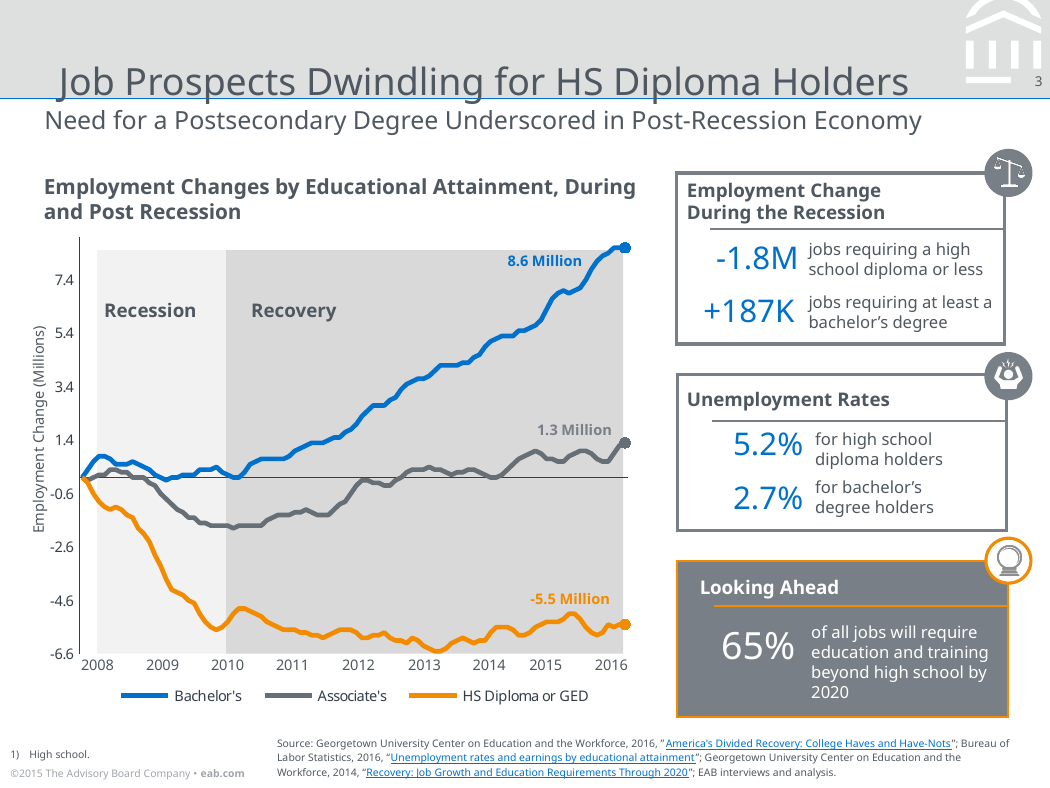
How many series does the chart legend list? 3 Which series has the lowest employment change at the end of the chart? HS Diploma or GED What is the employment change for HS Diploma or GED at the end of the line in 2016? -5.5 Million Is the value for HS Diploma or GED in 2013 greater or less than -4.6? less Which series has the highest employment change at the end of the chart? Bachelor's What is the employment change for Bachelor's at the end of the line in 2016? 8.6 Million At 2016, which is larger: the Bachelor's value or the Associate's value? Bachelor's What is the difference between the Bachelor's and Associate's end values labeled on the chart? 7.3 Million What is the employment change for Associate's at the end of the line in 2016? 1.3 Million What are the two labeled periods shaded on the chart? Recession and Recovery What kind of chart is shown on the slide? Line chart Does the Bachelor's line rise or fall from 2010 to 2016? Rises